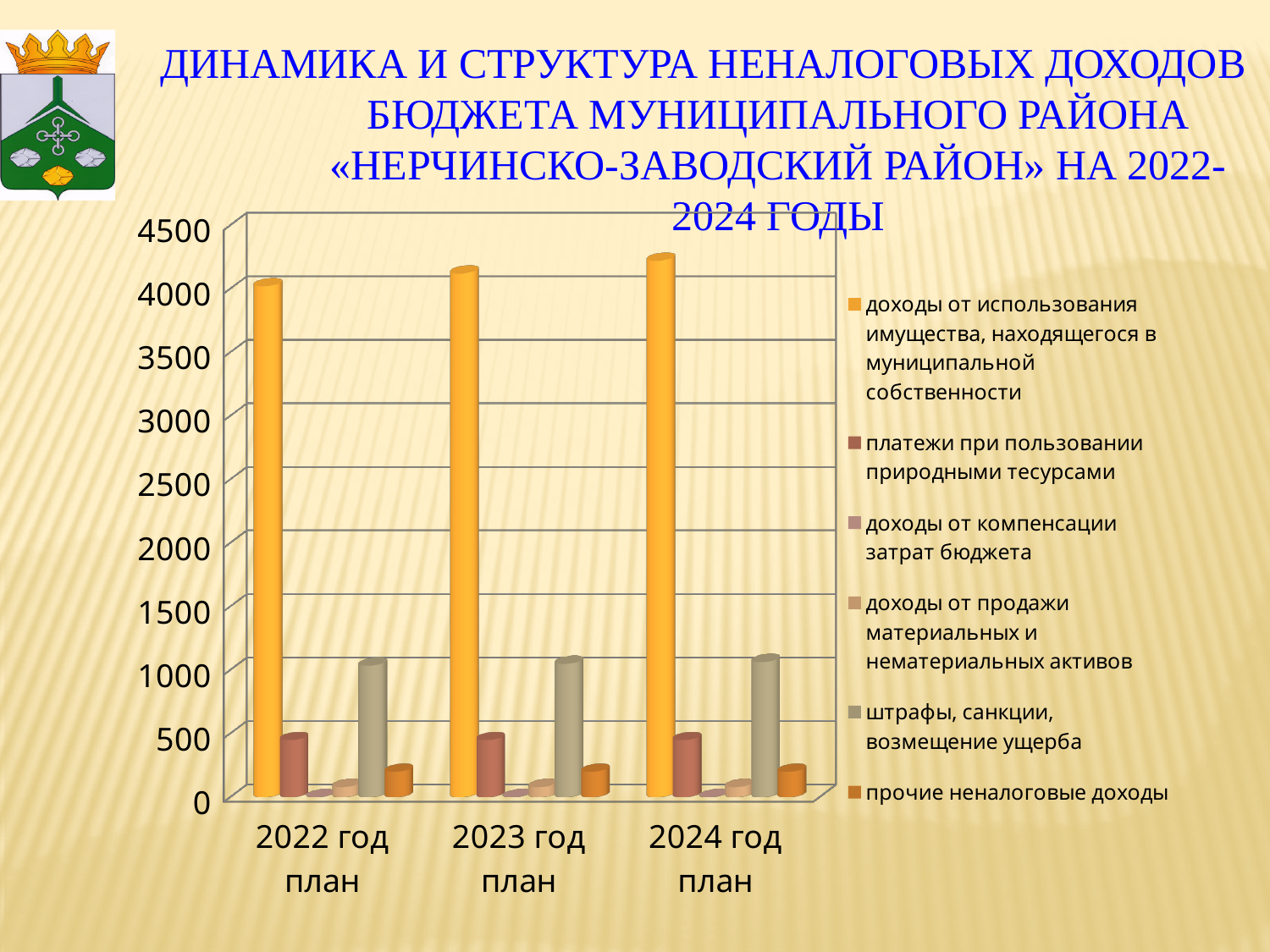
In 2023 год план, which is larger: штрафы, санкции, возмещение ущерба or платежи при пользовании природными тесурсами? штрафы, санкции, возмещение ущерба Which series has the highest value in the 2024 год план category? доходы от использования имущества, находящегося в муниципальной собственности Do the values for доходы от использования имущества rise or fall from 2022 год план to 2024 год план? rise How many series does the chart legend list? 6 Is the value for прочие неналоговые доходы in 2022 год план greater or less than 500? less Is the value for платежи при пользовании природными тесурсами in 2024 год план greater or less than 1000? less Which series is shown in grey in the chart legend? штрафы, санкции, возмещение ущерба What kind of chart is shown on the slide? bar chart How many categories (years) are shown on the x axis of the chart? 3 Is the value for доходы от использования имущества in 2022 год план greater or less than 3500? greater Which series has the lowest value in the 2022 год план category? доходы от компенсации затрат бюджета